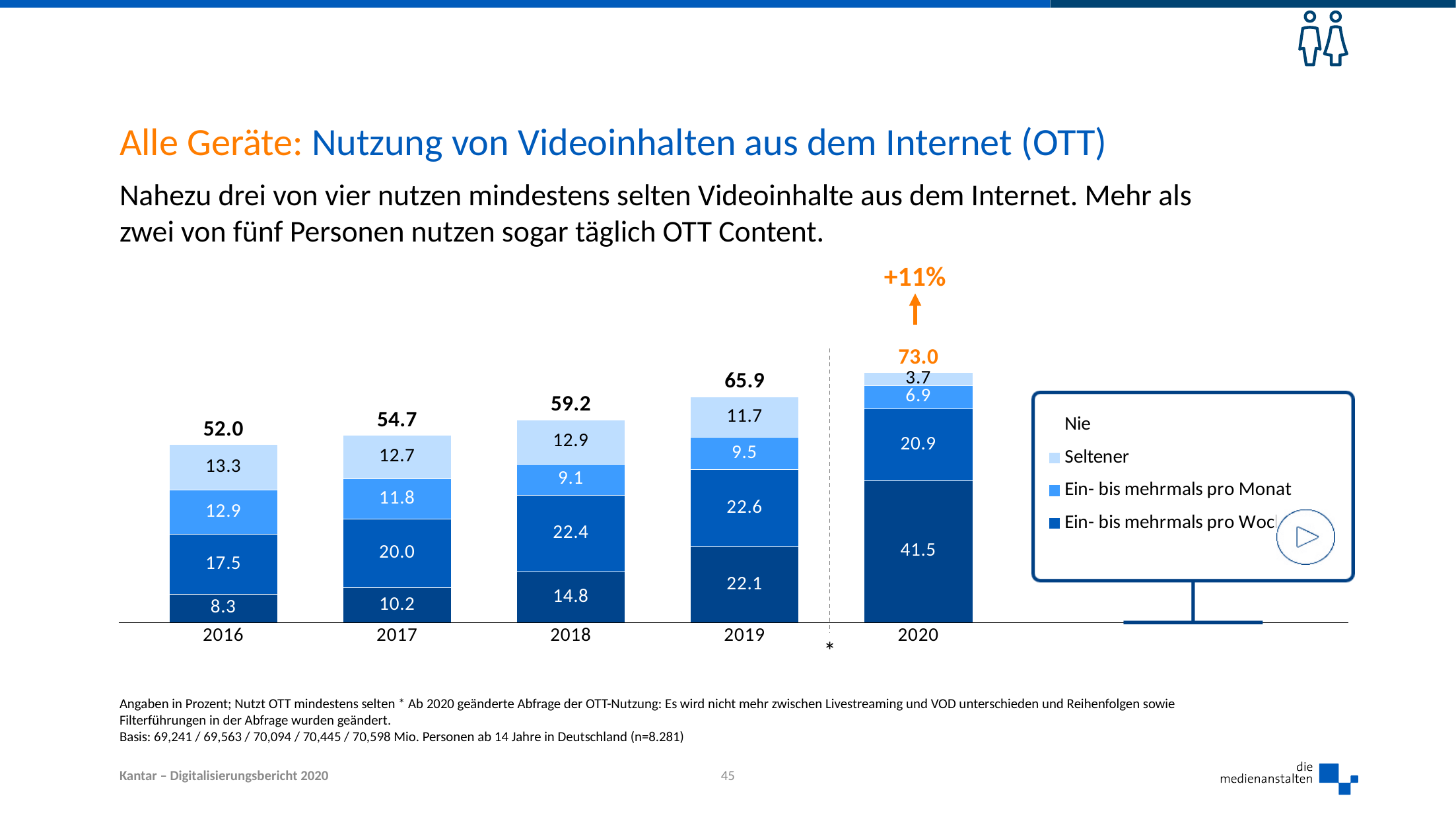
What is the value of the 'Seltener' segment for 2016? 13.3 Which year has the larger 'Seltener' value, 2018 or 2019? 2018 Do the bar totals rise or fall from 2016 to 2020? rise What is the value of the bottom (darkest) segment of the 2020 bar? 41.5 How many years are shown on the x axis? 5 What is the total value shown above the 2020 bar? 73.0 What kind of chart is shown on the slide? stacked bar chart What is the value of the 'Ein- bis mehrmals pro Monat' segment for 2019? 9.5 Which year has the lowest total value? 2016 What is the difference between the total for 2020 and the total for 2019? 7.1 Which year has the highest total value? 2020 What percentage change is annotated in orange above the 2020 bar? +11%